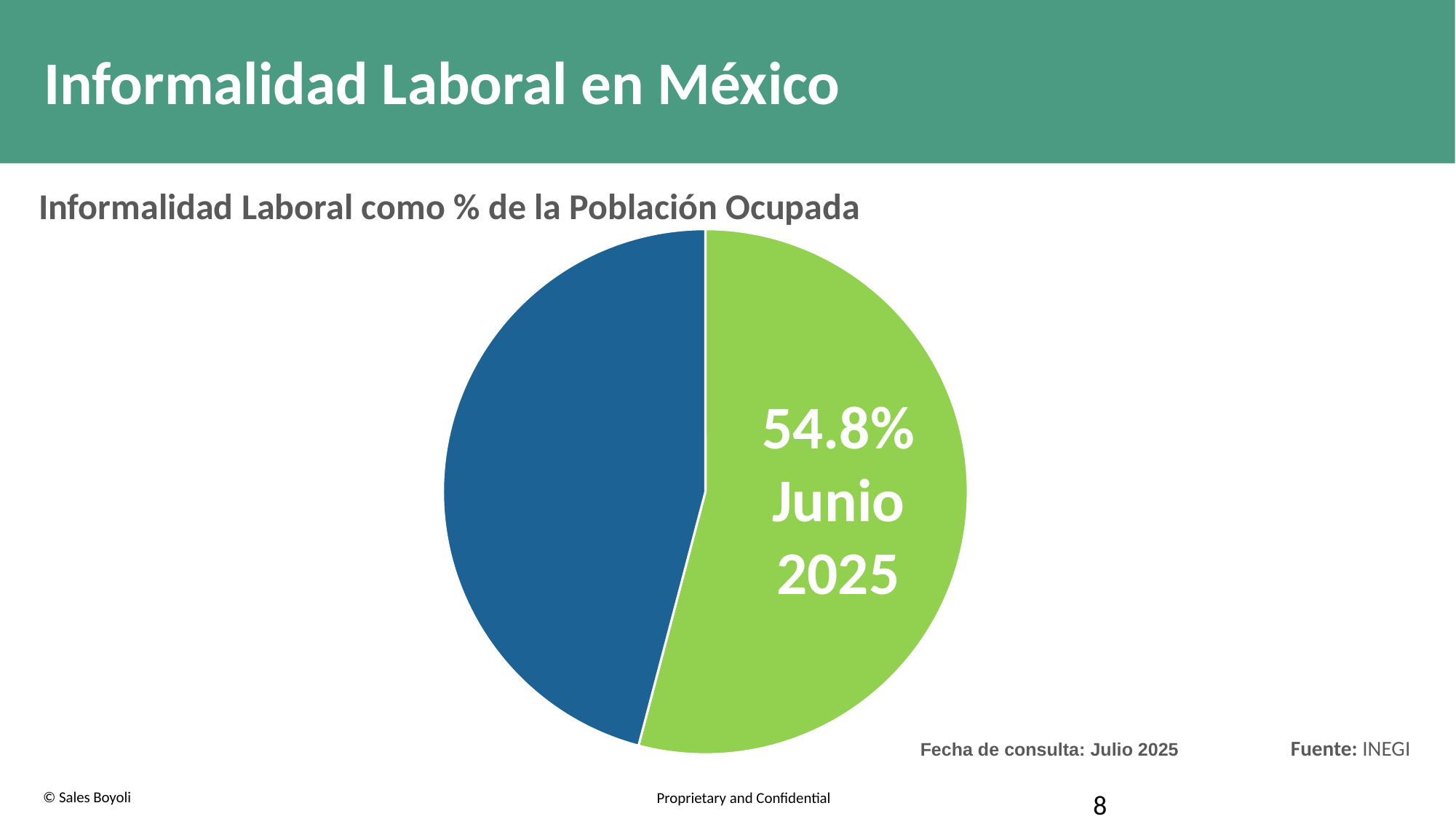
What is the title of the chart? Informalidad Laboral como % de la Población Ocupada What value is printed on the green slice of the pie chart? 54.8% Is the value of the green slice greater or less than 50%? greater What source is cited for the chart data? INEGI Which slice is larger, the green slice or the blue slice? green How many slices does the pie chart have? 2 What share of the pie does the green slice labelled Junio 2025 represent? 54.8% What kind of chart is shown on the slide? pie chart Which month and year is labelled on the green slice? Junio 2025